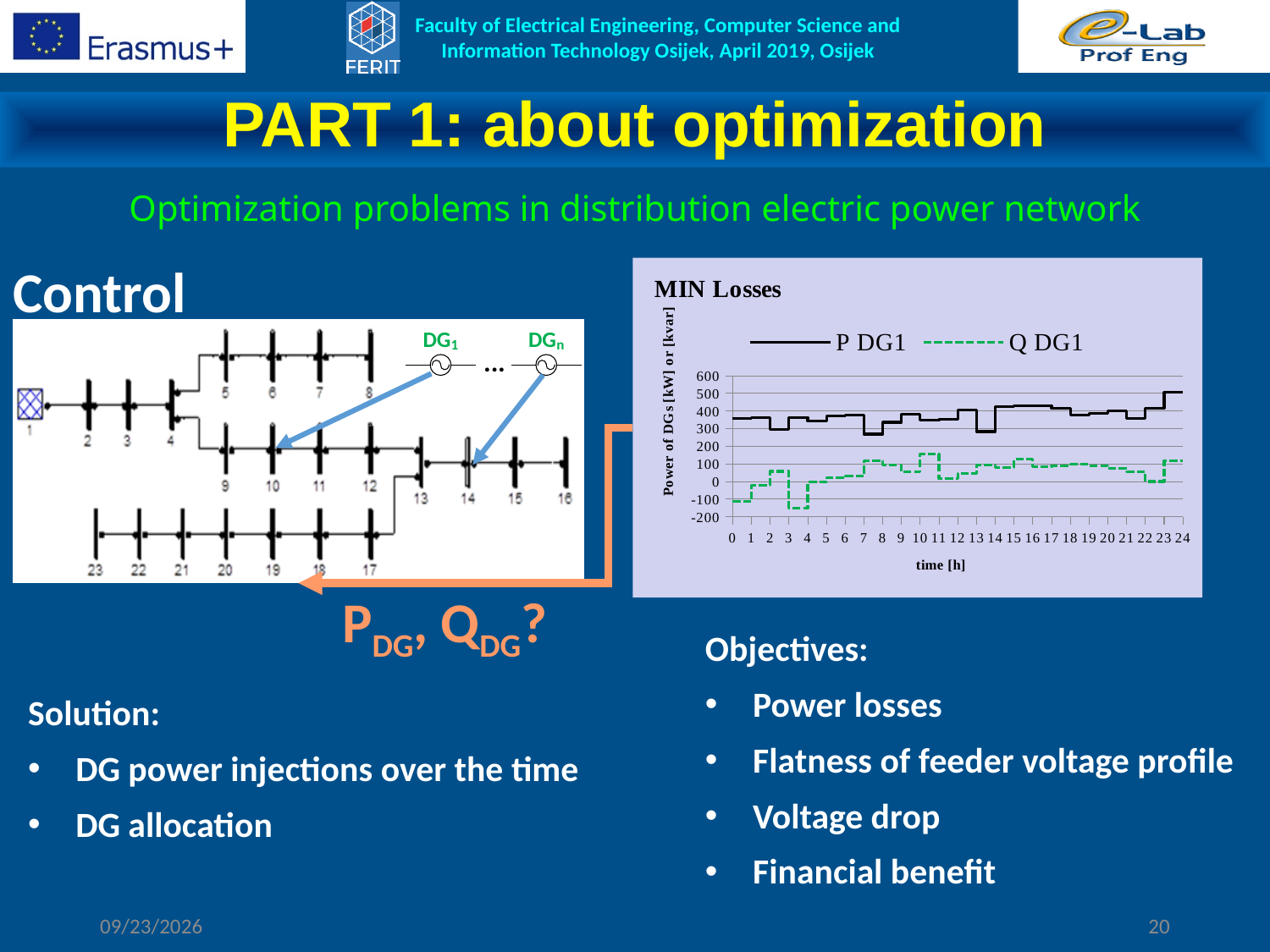
In the MIN Losses chart, which series has the larger value at hour 12, P DG1 or Q DG1? P DG1 In the MIN Losses chart, is the value of P DG1 at hour 24 greater or less than 400? greater What kind of chart is shown on the slide? line chart In the MIN Losses chart, is the value of P DG1 at hour 0 greater or less than 300? greater In the MIN Losses chart, does the Q DG1 series overall rise or fall between hour 0 and hour 24? rise What are the two series named in the legend of the MIN Losses chart? P DG1 and Q DG1 What is the title of the chart on the slide? MIN Losses In the MIN Losses chart, which series is higher across the whole 24-hour period, P DG1 or Q DG1? P DG1 How many series does the legend of the MIN Losses chart list? 2